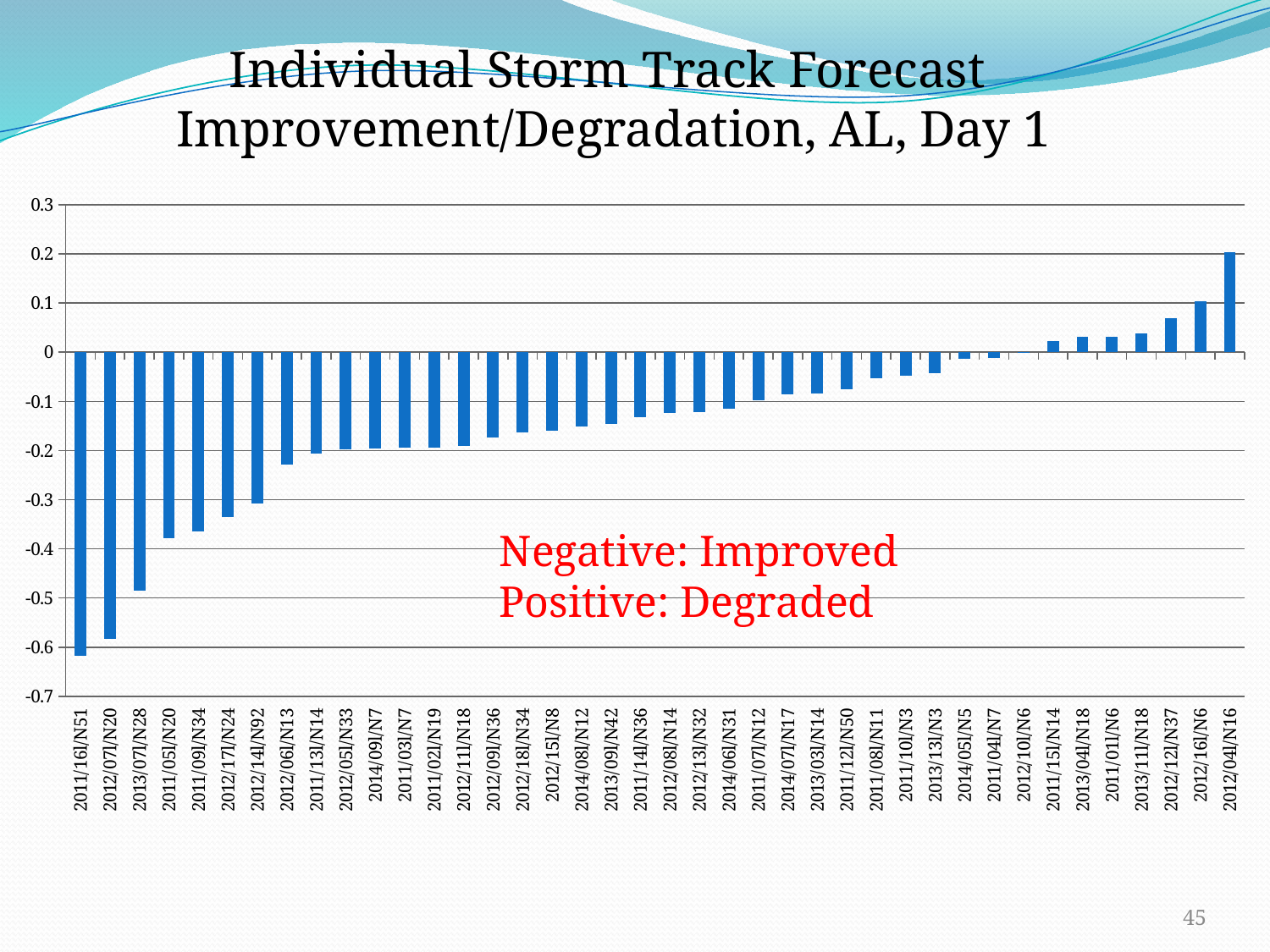
Is the value for 2012/04/N16 greater or less than 0.1? greater Is the value for 2011/16/N51 greater or less than -0.5? less Do the bar values rise or fall moving from left to right along the x axis? rise According to the annotation on the chart, what does a negative value indicate? Improved Which storm has the highest value? 2012/04l/N16 What kind of chart is shown on the slide? bar chart Is the value for 2012/07/N20 greater or less than -0.5? less Which has the larger value, 2011/16/N51 or 2012/04/N16? 2012/04l/N16 Which storm has the lowest (most negative) value? 2011/16l/N51 How many storm categories are plotted along the x axis? 40